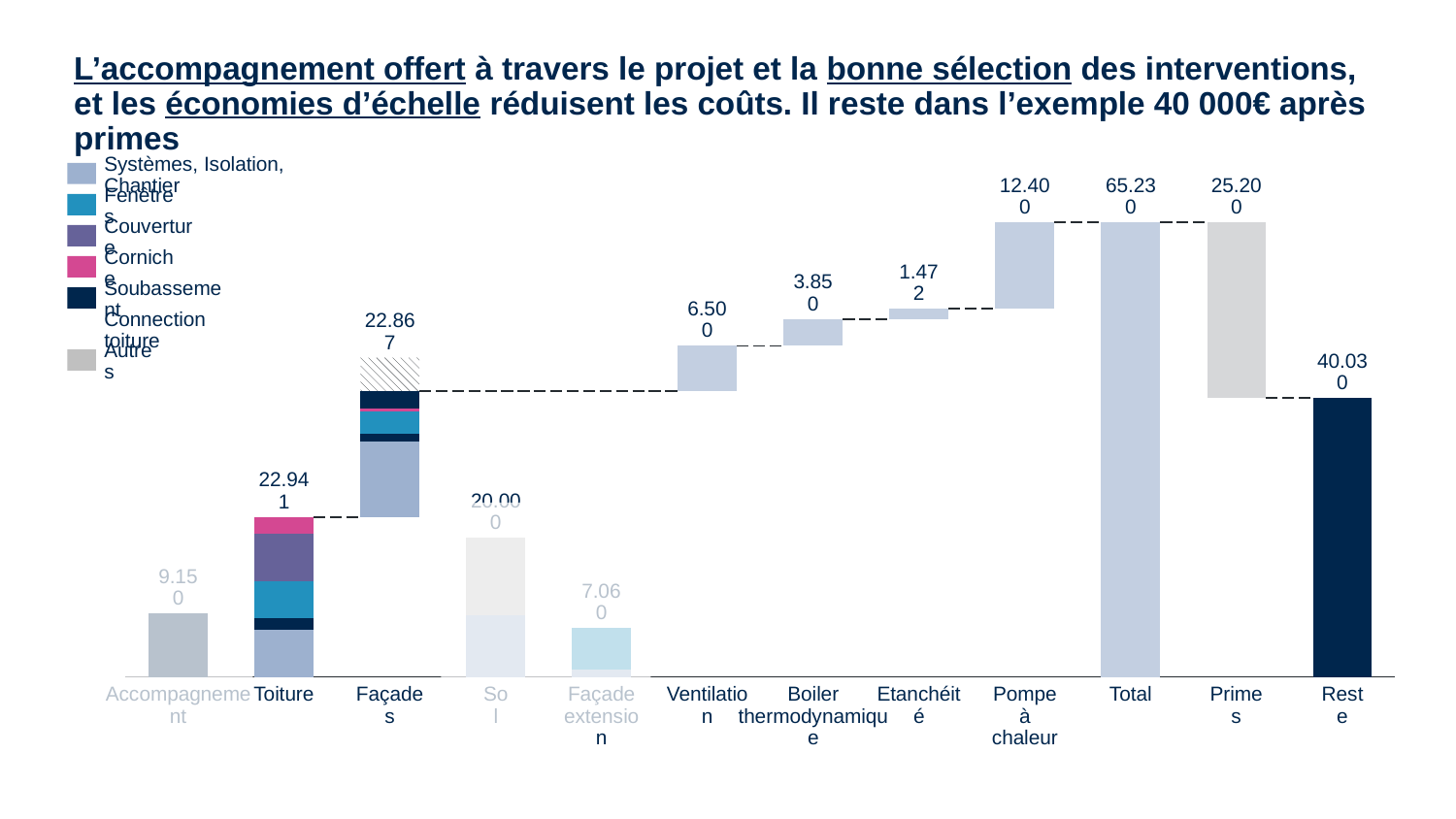
How many categories are shown along the x axis? 12 Which category has the highest value label on the chart? Total How many entries does the legend list? 7 Which is larger, the value for Ventilation or the value for Boiler thermodynamique? Ventilation What is the value shown for Primes? 25.200 What is the difference between the Total value and the Primes value? 40.030 What is the difference between the Pompe à chaleur value and the Etanchéité value? 10.928 Which category has the lowest value label on the chart? Etanchéité What is the value shown for Total? 65.230 What is the value shown for Toiture? 22.941 What kind of chart is shown on the slide? bar chart What is the value shown for Reste? 40.030